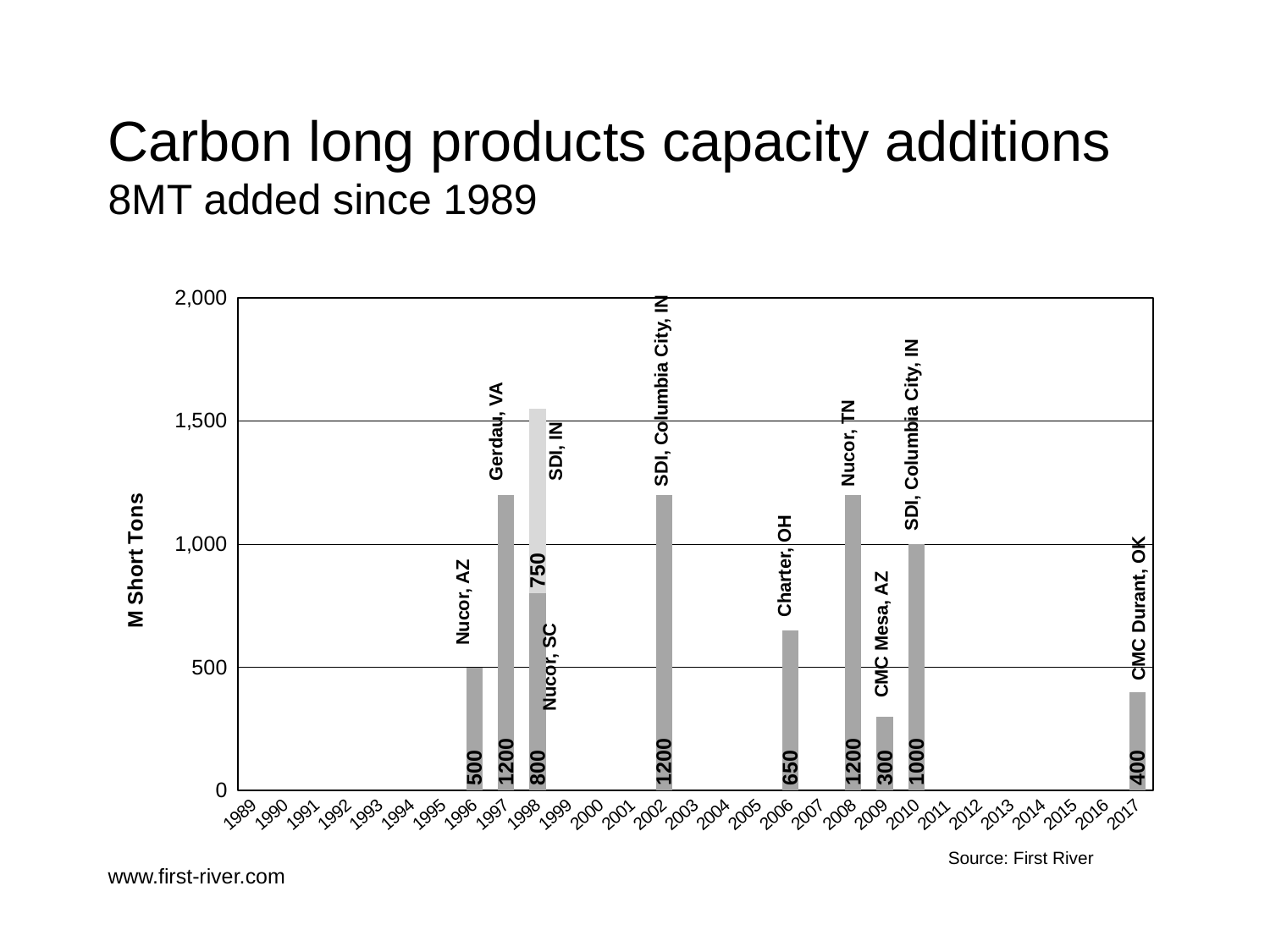
How many years on the x axis have a capacity addition bar? 9 Is the value for Charter, OH in 2006 greater or less than 500? greater Which is larger: the addition in 2010 (SDI, Columbia City, IN) or the addition in 2006 (Charter, OH)? 2010 (SDI, Columbia City, IN) What is the total height of the stacked bar in 1998 (Nucor, SC plus SDI, IN)? 1550 What is the capacity addition shown for Nucor, AZ in 1996? 500 What is the difference between the Gerdau, VA addition in 1997 and the Nucor, AZ addition in 1996? 700 What value is labelled on the bar for Charter, OH in 2006? 650 Which capacity addition has the lowest labelled value on the chart? CMC Mesa, AZ (300) What kind of chart is shown on the slide? bar chart What value is shown for SDI, Columbia City, IN in 2010? 1000 What is the capacity addition labelled for CMC Durant, OK in 2017? 400 Which year has the tallest bar on the chart? 1998